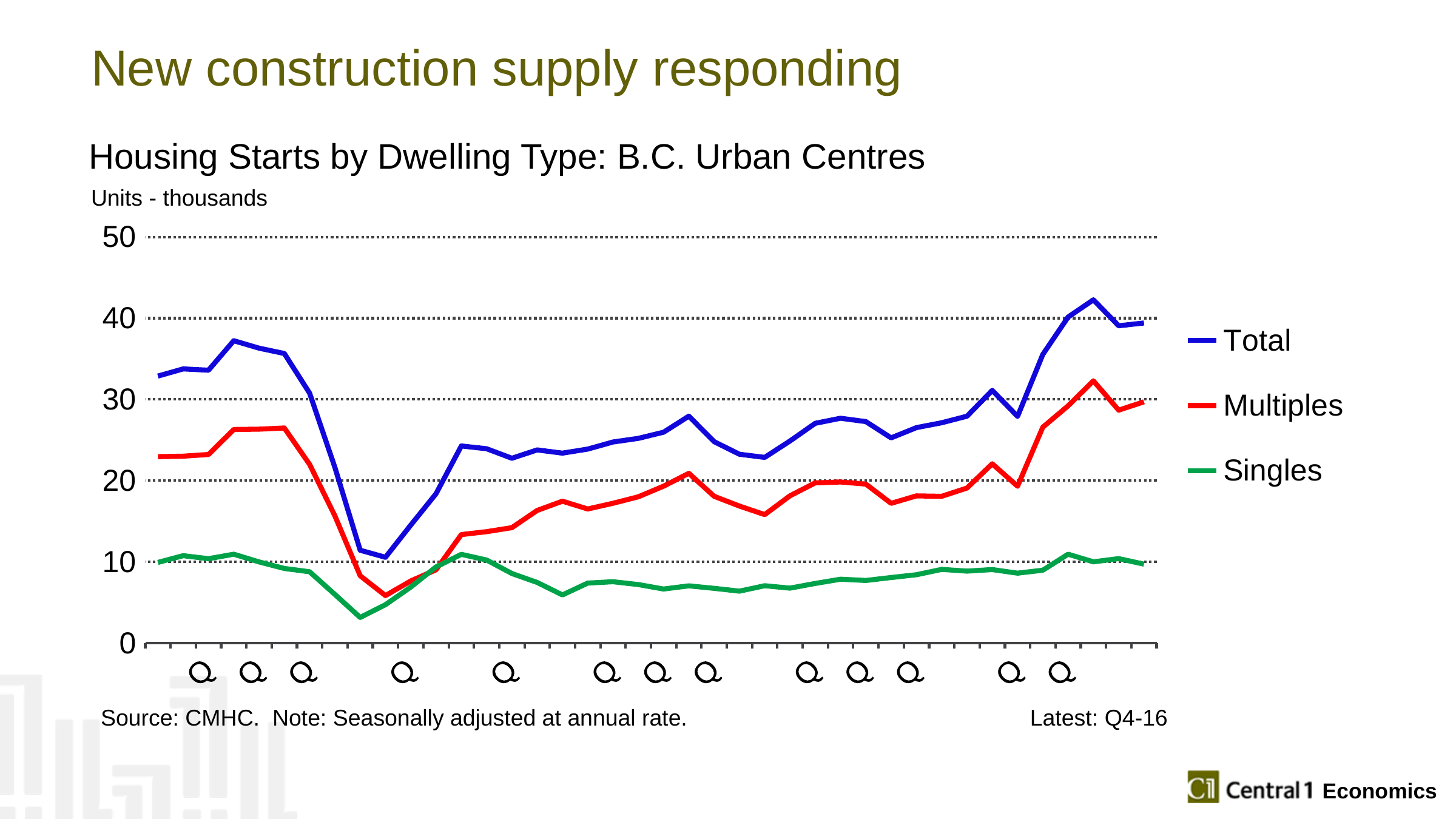
Which series has the lowest values across most of the chart? Singles At the final point of the chart, which series is higher, Multiples or Singles? Multiples Is the highest value reached by the Total series greater or less than 40? greater What kind of chart is shown on the slide? line chart Is the final (latest) value of the Multiples series greater or less than 20? greater Is the lowest value reached by the Singles series greater or less than 5? less Which series has the highest values across the whole chart? Total What are the series names listed in the legend? Total, Multiples, Singles How many series does the legend list? 3 What unit is the y axis measured in, according to the label above the chart? Units - thousands